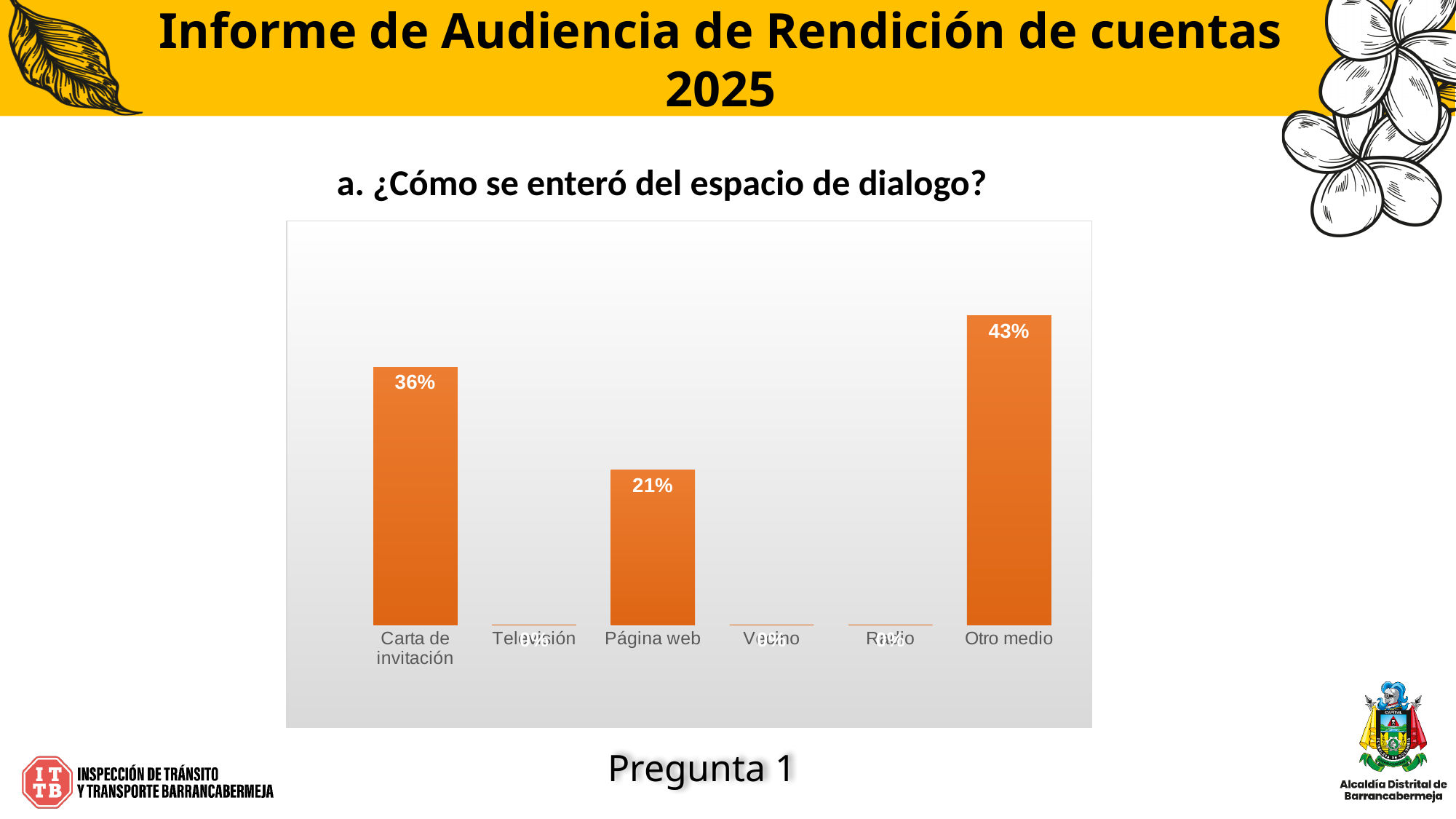
Which is larger, the value for 'Carta de invitación' or the value for 'Página web'? Carta de invitación What percentage is shown for 'Página web'? 21% What question does the chart on the slide answer? a. ¿Cómo se enteró del espacio de dialogo? What is the difference between the values for 'Carta de invitación' and 'Página web'? 15% What percentage of respondents learned about the dialogue space through 'Carta de invitación'? 36% What is the difference between the values for 'Otro medio' and 'Carta de invitación'? 7% What kind of chart is shown on the slide? Bar chart Which category has the highest value in the chart? Otro medio What is the value shown for 'Televisión'? 0% What is the difference between the values for 'Otro medio' and 'Página web'? 22% How many categories are shown on the x axis of the chart? 6 What is the value shown for 'Otro medio'? 43%